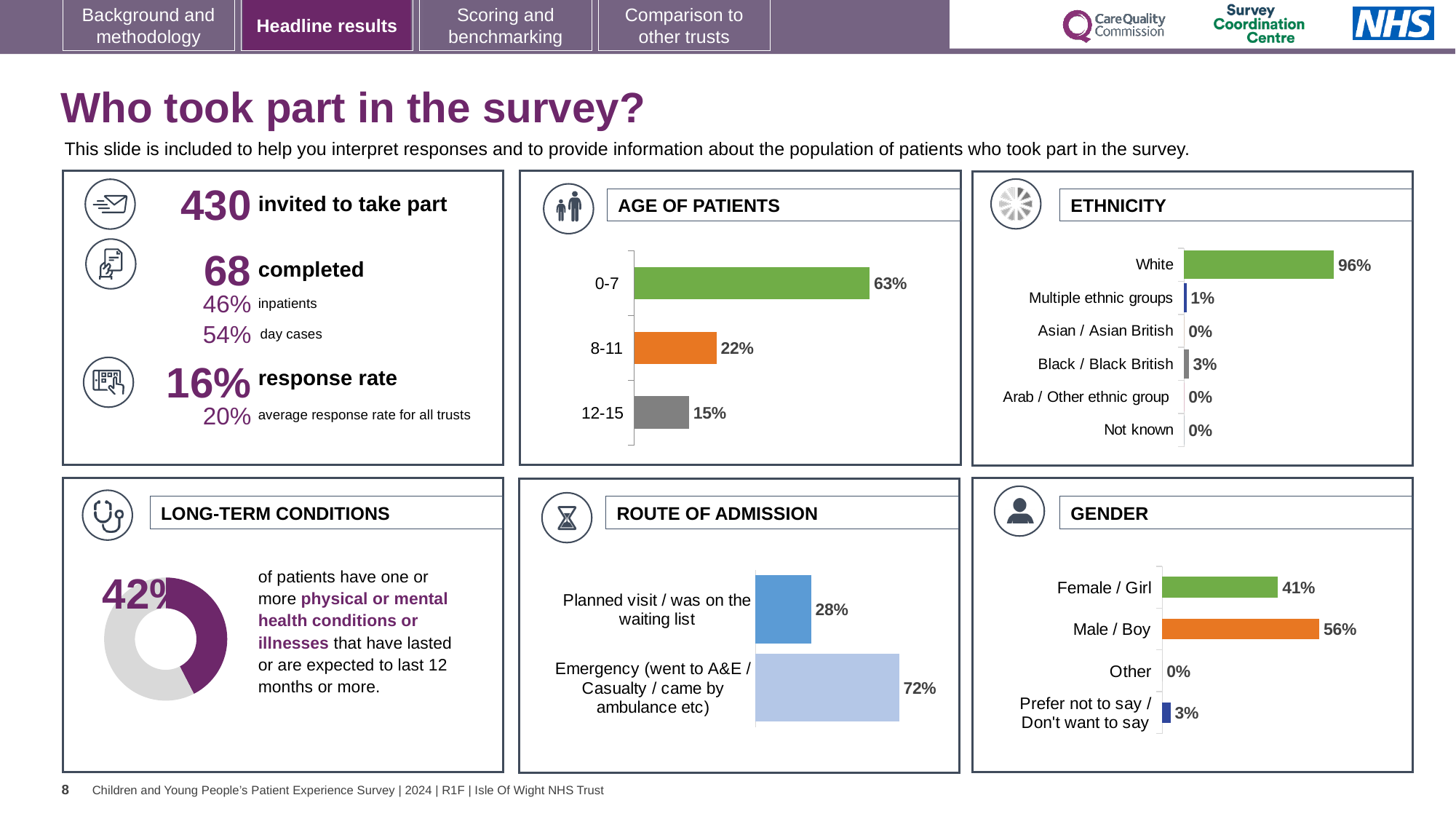
In the ETHNICITY chart, what percentage of patients were White? 96% In the ETHNICITY chart, how many ethnicity categories are shown? 6 In the ROUTE OF ADMISSION chart, which route has the larger percentage: Planned visit or Emergency? Emergency (went to A&E / Casualty / came by ambulance etc) In the GENDER chart, what percentage of patients were Male / Boy? 56% In the AGE OF PATIENTS chart, what percentage of patients were aged 0-7? 63% In the AGE OF PATIENTS chart, which age group has the lowest percentage? 12-15 In the GENDER chart, what is the difference between the Male / Boy and Female / Girl percentages? 15% In the ROUTE OF ADMISSION chart, what percentage of patients came via Emergency (went to A&E / Casualty / came by ambulance etc)? 72% In the AGE OF PATIENTS chart, what is the difference between the 0-7 and 8-11 percentages? 41% What kind of chart is used in the LONG-TERM CONDITIONS panel? Doughnut chart In the ETHNICITY chart, what percentage is shown for Black / Black British? 3% In the LONG-TERM CONDITIONS chart, what percentage of patients have one or more long-term conditions? 42%